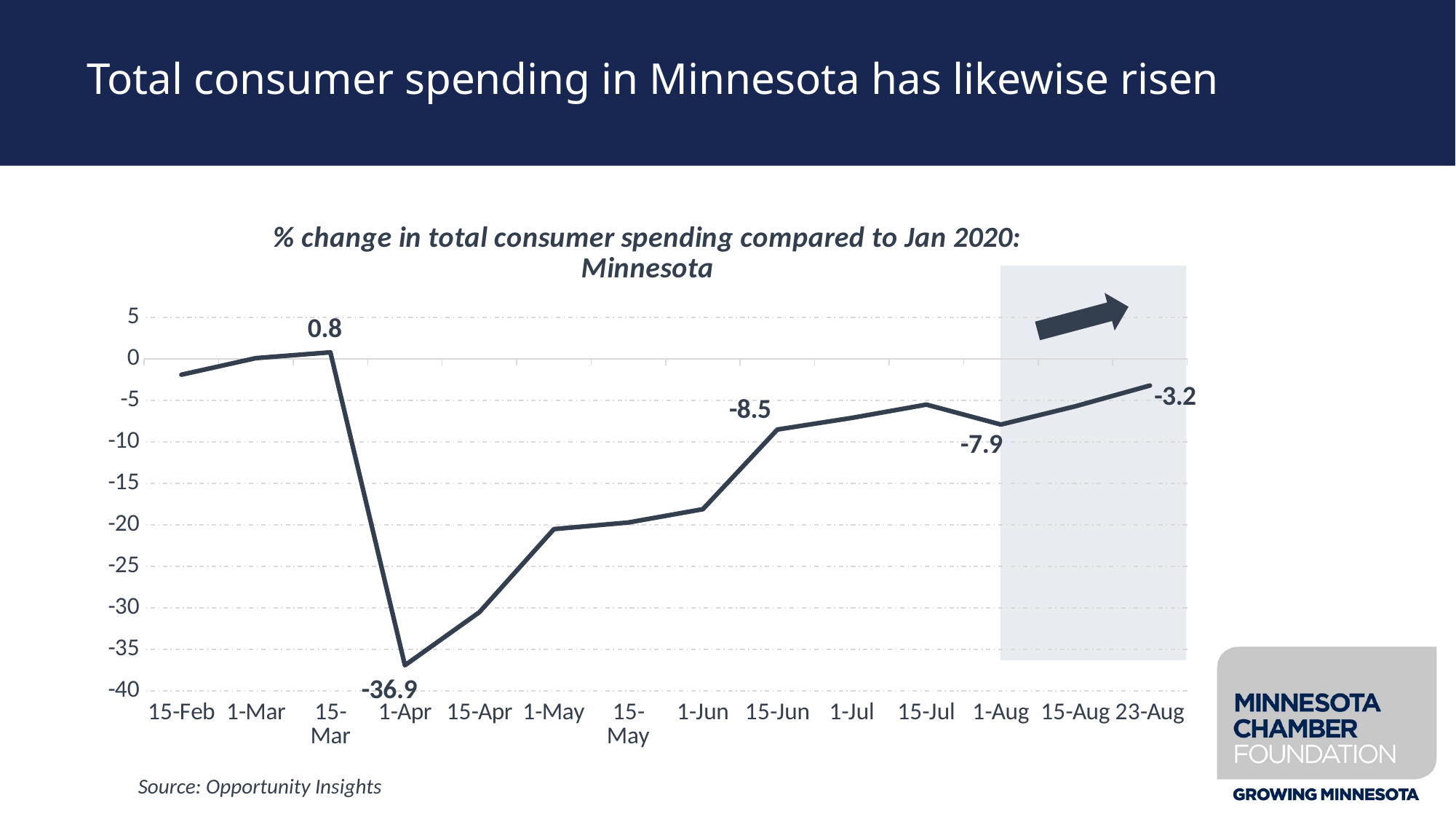
What is the difference between the values for 23-Aug and 1-Aug? 4.7 Which date has the lowest value? 1-Apr What is the value for 1-Aug? -7.9 What is the value for 1-Apr? -36.9 How many data points are plotted on the line? 14 What is the value for 15-Mar? 0.8 Which is larger, the value for 15-Jun or the value for 1-Aug? 1-Aug Is the value for 1-Jun greater or less than -20? greater What is the value for 15-Jun? -8.5 Which date has the highest value? 15-Mar What is the value for 23-Aug? -3.2 What kind of chart is shown? line chart